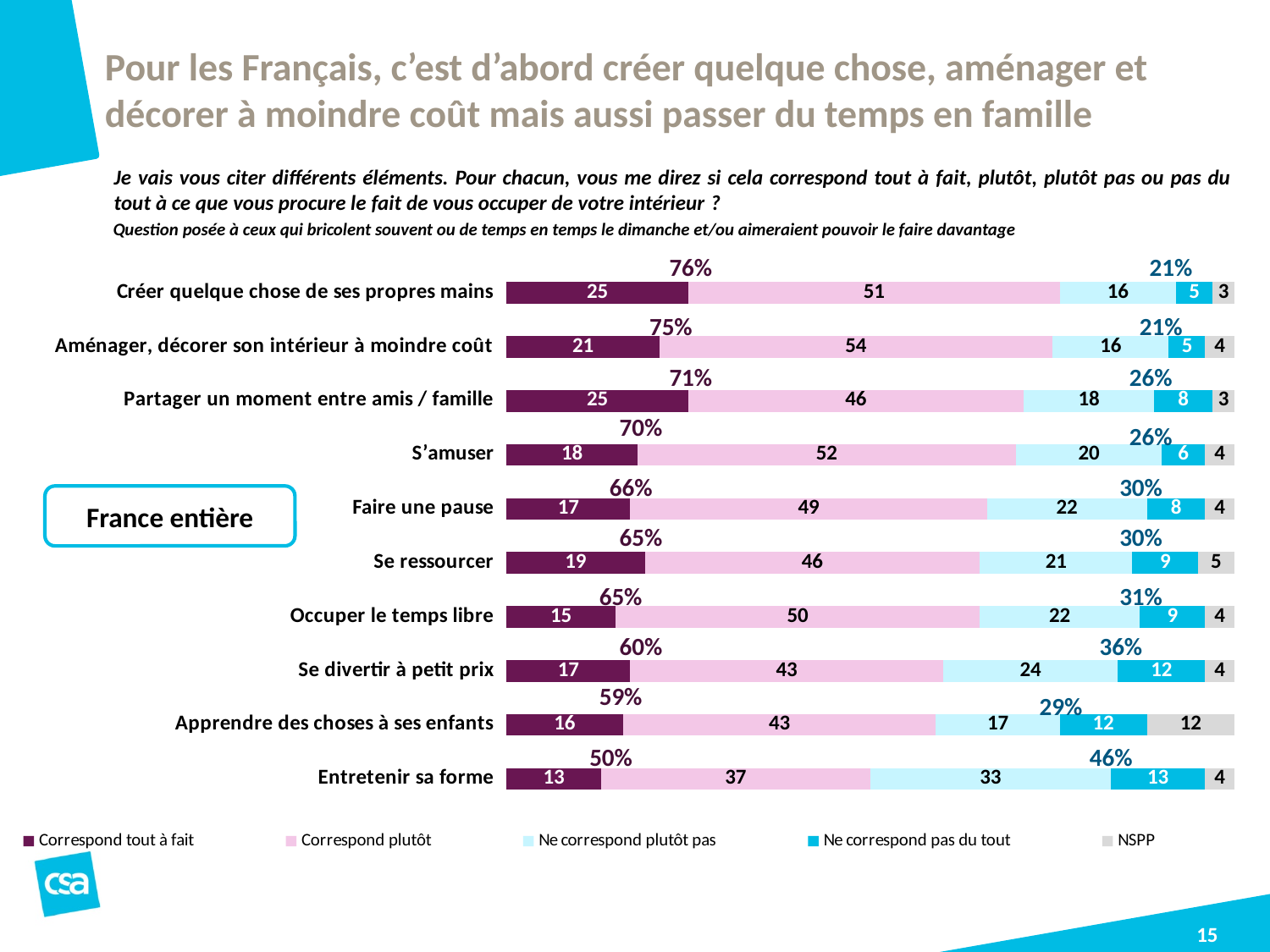
How many series does the legend list? 5 What is the value of "NSPP" for "Apprendre des choses à ses enfants"? 12 What is the combined total of "Correspond tout à fait" and "Correspond plutôt" for "Partager un moment entre amis / famille"? 71% What is the difference between the "Correspond plutôt" values for "S'amuser" and "Se divertir à petit prix"? 9 Which is larger: the "Ne correspond pas du tout" value for "Se ressourcer" or for "S'amuser"? Se ressourcer What is the label in the box to the left of the chart? France entière What is the value of "Ne correspond plutôt pas" for "Entretenir sa forme"? 33 What kind of chart is shown on the slide? Stacked bar chart How many categories are shown in the chart? 10 What is the value of "Correspond plutôt" for "Aménager, décorer son intérieur à moindre coût"? 54 Which category has the lowest value for "Correspond tout à fait"? Entretenir sa forme Which category has the highest value for "Correspond plutôt"? Aménager, décorer son intérieur à moindre coût